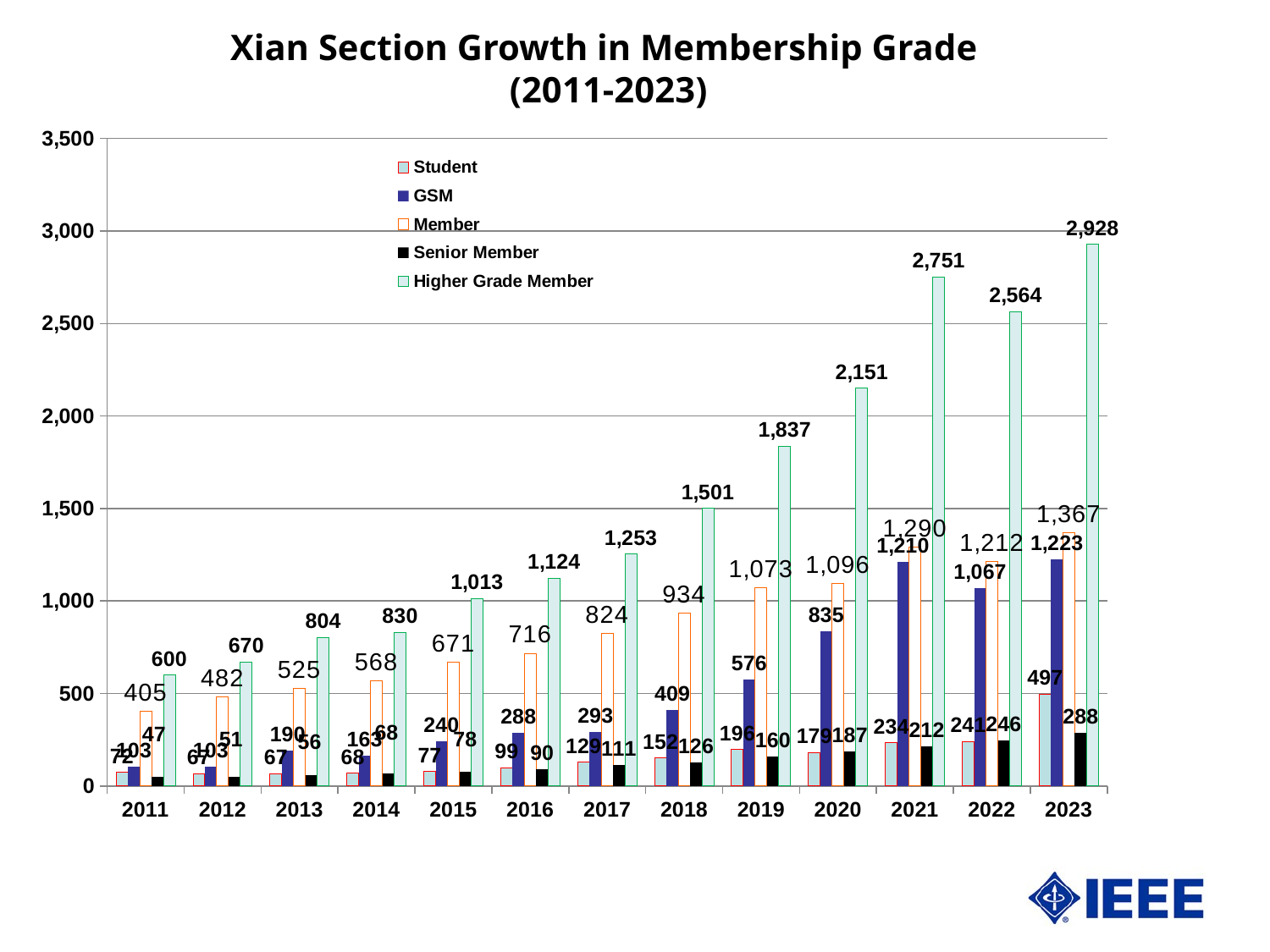
How many years are shown on the x axis? 13 In which year is the Higher Grade Member value lowest? 2011 Does the Higher Grade Member value rise or fall from 2011 to 2021? rise How many series does the legend list? 5 What is the value for GSM in 2020? 835 What is the difference between the Higher Grade Member values for 2021 and 2022? 187 What is the value for Senior Member in 2023? 288 What kind of chart is shown on the slide? bar chart In which year is the Higher Grade Member value highest? 2023 What is the value for Higher Grade Member in 2023? 2,928 What is the value for Member in 2018? 934 Which year has the larger GSM value, 2021 or 2022? 2021